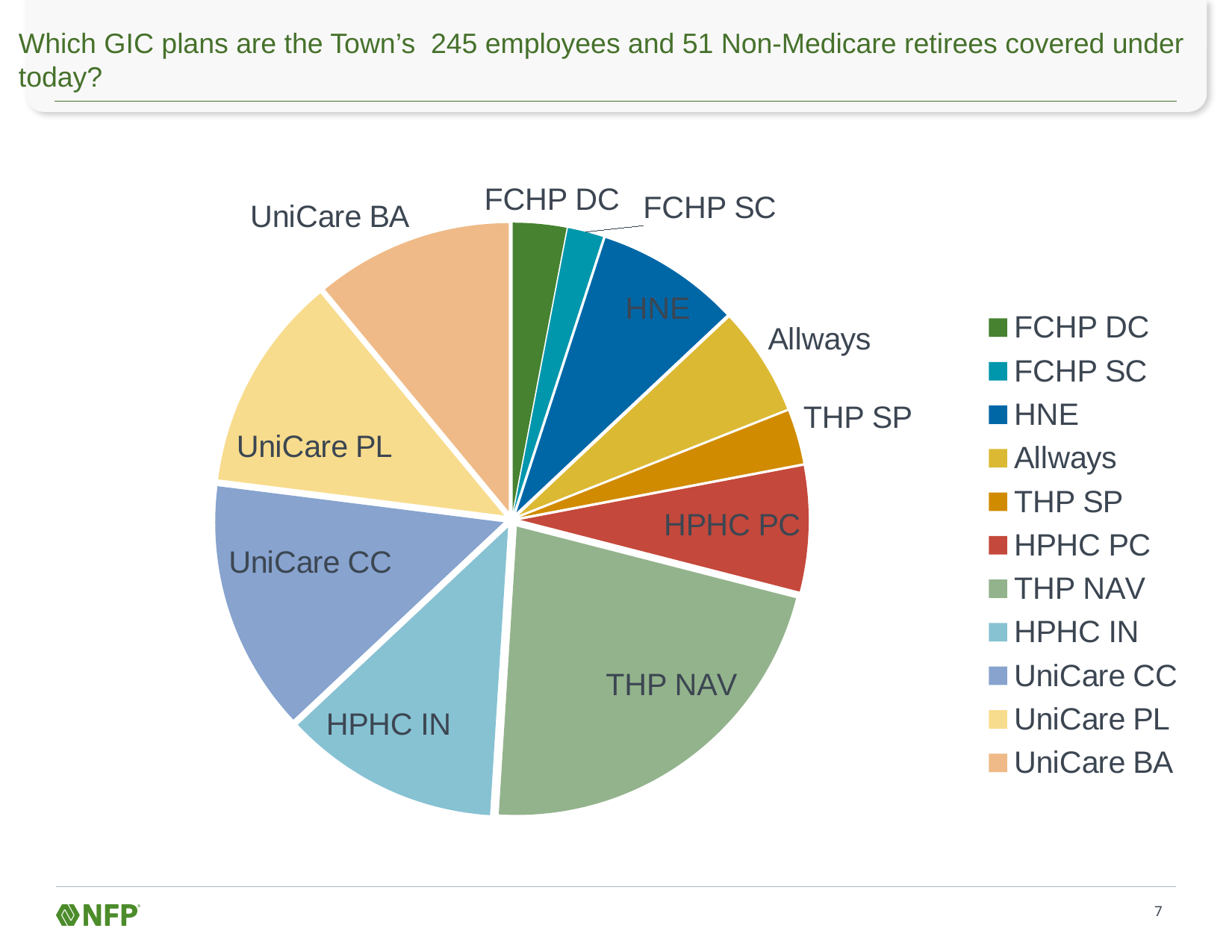
Which slice is larger, UniCare PL or Allways? UniCare PL Which plan has the smallest slice of the pie? FCHP SC Which slice is larger, HPHC IN or FCHP SC? HPHC IN What kind of chart is shown on the slide? pie chart Which plan has the largest slice of the pie? THP NAV How many plans (slices) does the pie chart show? 11 Which slice is larger, UniCare CC or THP SP? UniCare CC What colour is the THP NAV slice? green Which plan is listed first in the legend? FCHP DC How many entries does the legend list? 11